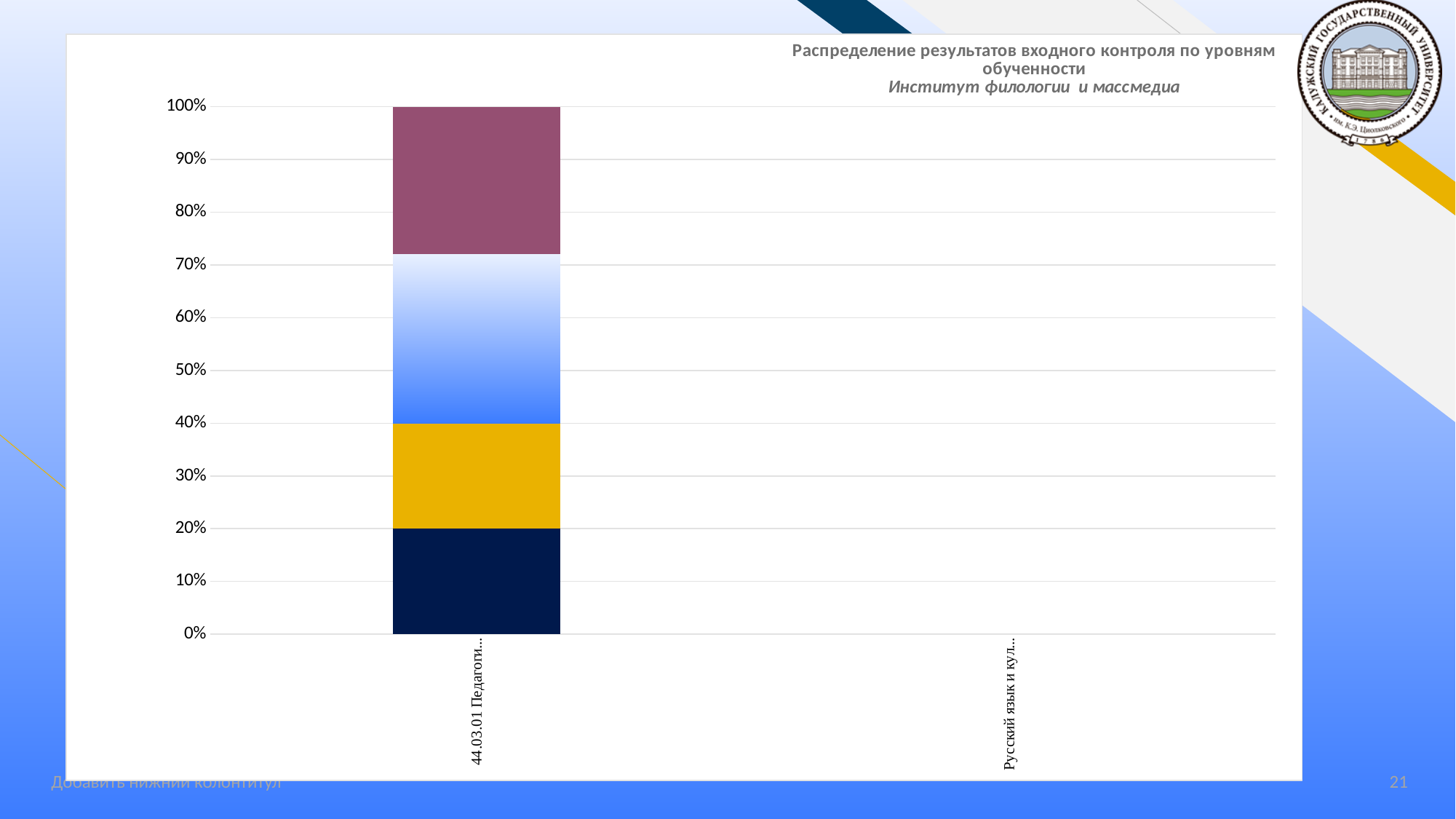
What is the highest value shown on the vertical axis? 100% What kind of chart is shown on the slide? stacked bar chart Is a bar plotted for the category "Русский язык и кул..."? No At what value on the axis does the top of the yellow segment of the "44.03.01 Педагоги..." bar sit? 40% How many category labels are shown on the x axis of the chart? 2 Which segment is at the top of the stacked bar for "44.03.01 Педагоги..."? the purple segment At what value on the axis does the top of the bottom (dark navy) segment of the "44.03.01 Педагоги..." bar sit? 20% Is the top of the blue gradient segment in the "44.03.01 Педагоги..." bar greater or less than 70%? greater What is the total height of the stacked bar for "44.03.01 Педагоги..."? 100% How many stacked segments make up the bar for "44.03.01 Педагоги..."? 4 Is the top of the blue gradient segment in the "44.03.01 Педагоги..." bar greater or less than 80%? less What is the title of the chart? Распределение результатов входного контроля по уровням обученности Институт филологии и массмедиа